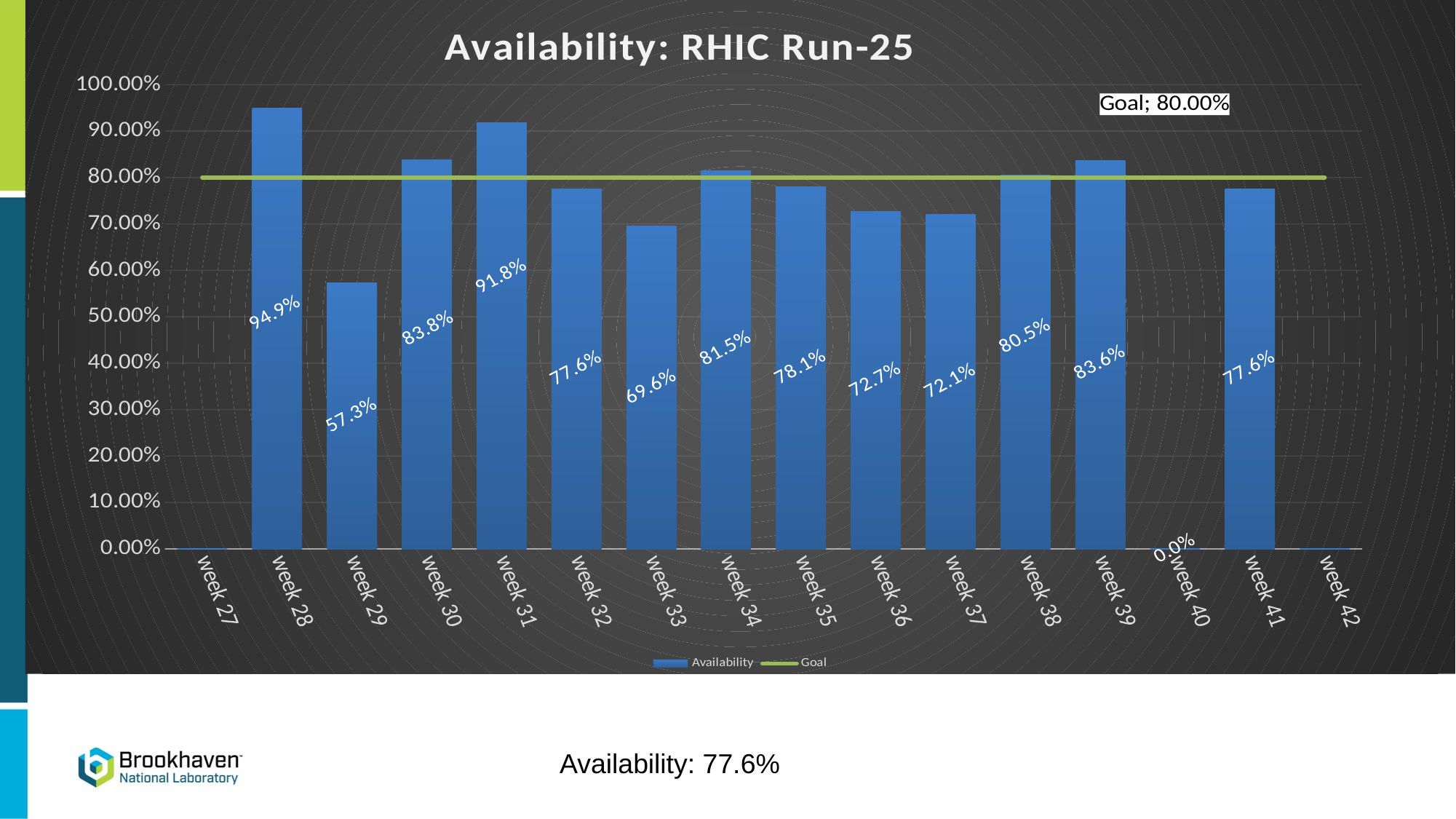
What is the availability for week 39? 83.6% What is the availability for week 28? 94.9% How many series does the legend list? 2 Which week has the highest availability? week 28 Which has the higher availability, week 34 or week 35? week 34 What is the availability for week 33? 69.6% How many week categories are shown on the x axis? 16 What is the value of the Goal line shown on the chart? 80.00% Is the availability for week 29 greater or less than 60.00%? less What kind of chart is shown on the slide? combination bar and line chart Among weeks 28 through 39, which week has the lowest availability? week 29 What is the difference in availability between week 28 and week 29? 37.6%